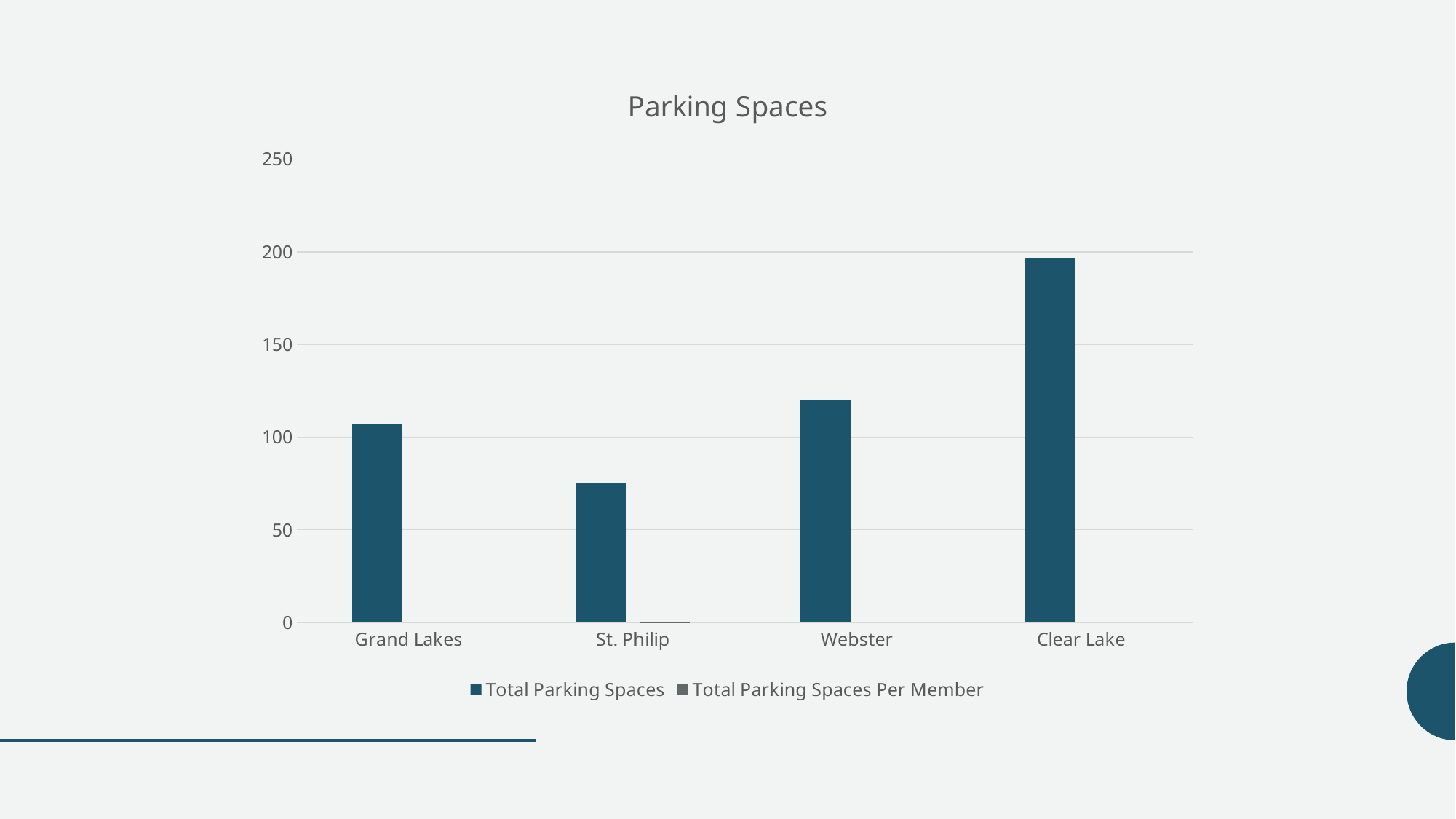
Is the Total Parking Spaces value for Webster greater or less than 150? less Which category has the lowest Total Parking Spaces? St. Philip Which category has the highest Total Parking Spaces? Clear Lake How many categories are shown on the x axis? 4 Is the Total Parking Spaces value for Clear Lake greater or less than 150? greater What type of chart is shown on the slide? bar chart Which has more Total Parking Spaces, Webster or Grand Lakes? Webster What are the two series named in the legend? Total Parking Spaces and Total Parking Spaces Per Member How many series does the legend list? 2 Is the Total Parking Spaces value for St. Philip greater or less than 100? less What is the title of the chart? Parking Spaces